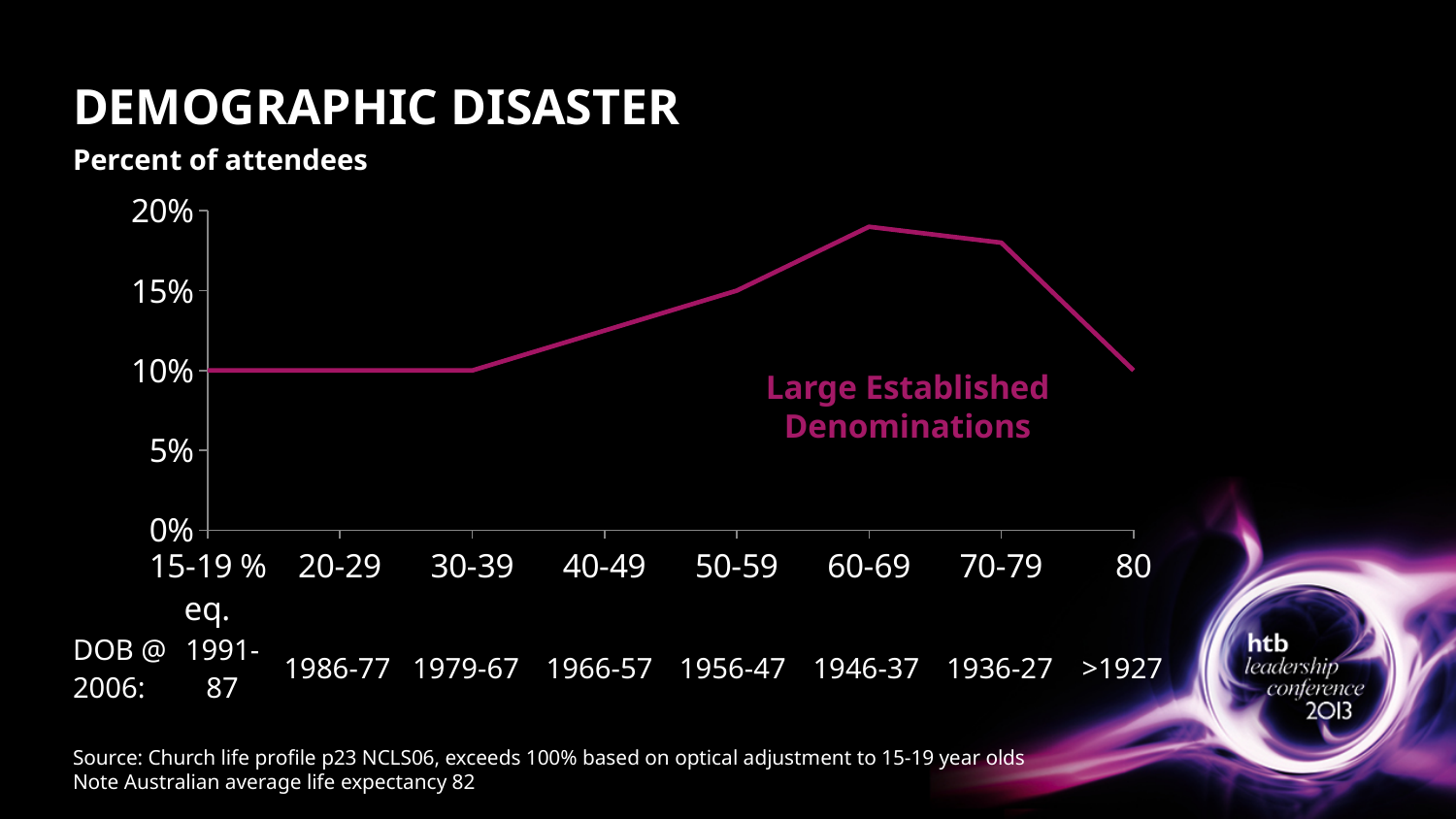
How many age categories are plotted along the x axis? 8 What is the percent of attendees for the 50-59 age category? 15% Which age category has the highest percent of attendees? 60-69 Is the value for the 70-79 age category greater or less than 15%? greater Do the values rise or fall from the 30-39 category to the 60-69 category? rise What is the percent of attendees for the 30-39 age category? 10% What is the difference between the values for the 50-59 and 30-39 age categories? 5% Is the value for the 60-69 age category greater or less than 15%? greater Is the value for the 40-49 age category greater or less than 15%? less What label is printed on the chart next to the line? Large Established Denominations What kind of chart is shown on the slide? line chart Which has a higher percent of attendees, the 60-69 category or the 80 category? 60-69